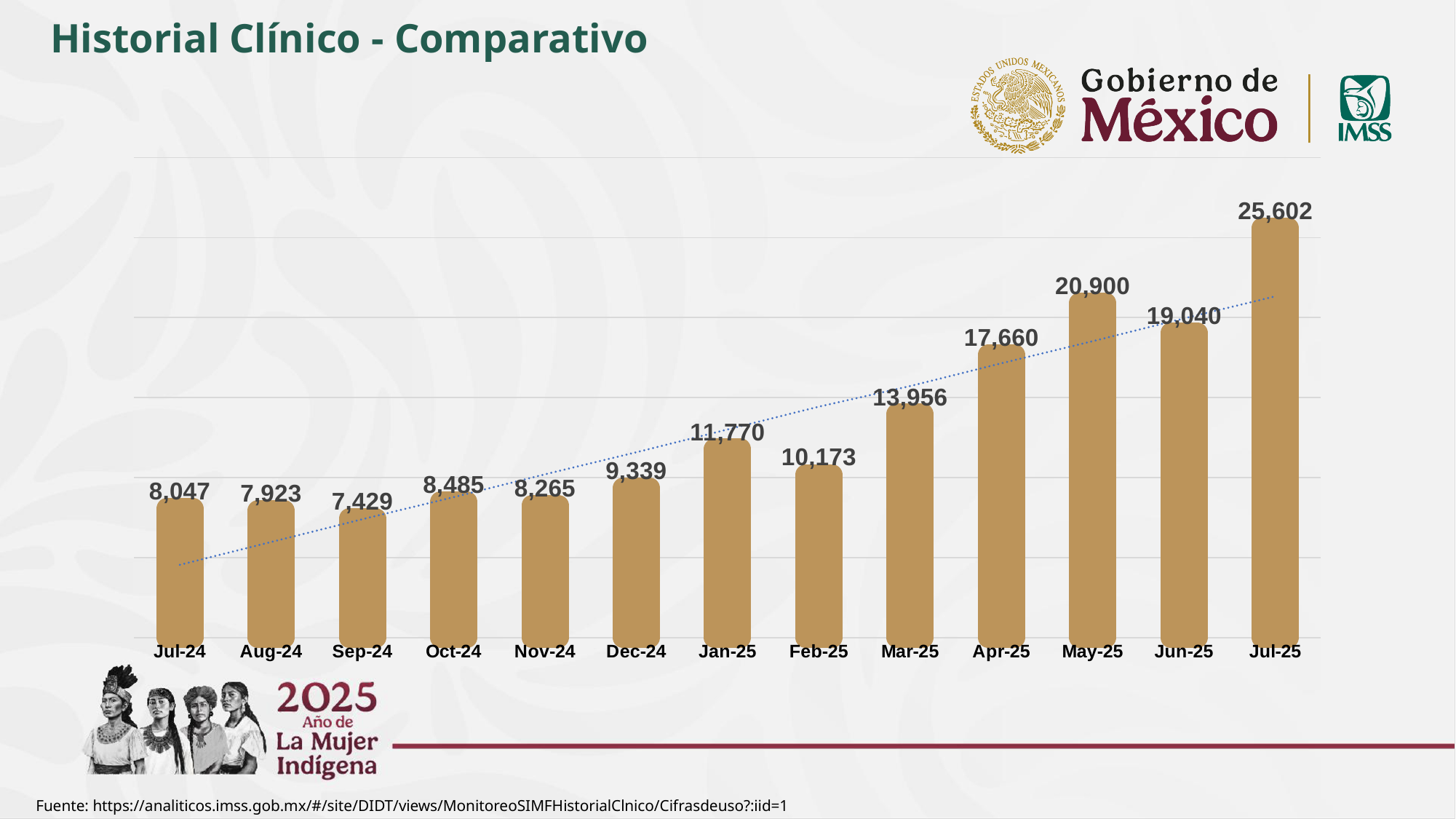
What is the value for Sep-24? 7,429 What is the title of the slide containing the chart? Historial Clínico - Comparativo What is the value for Jan-25? 11,770 Which month has the lowest value? Sep-24 What is the difference between the values for Jul-25 and Jul-24? 17,555 Which is larger, the value for Jan-25 or the value for Feb-25? Jan-25 What kind of chart is shown on the slide? Bar chart Do the values generally rise or fall from Jul-24 to Jul-25? Rise How many months are shown on the x axis? 13 What is the value for Jul-25? 25,602 What is the difference between the values for May-25 and Jun-25? 1,860 Which month has the highest value? Jul-25